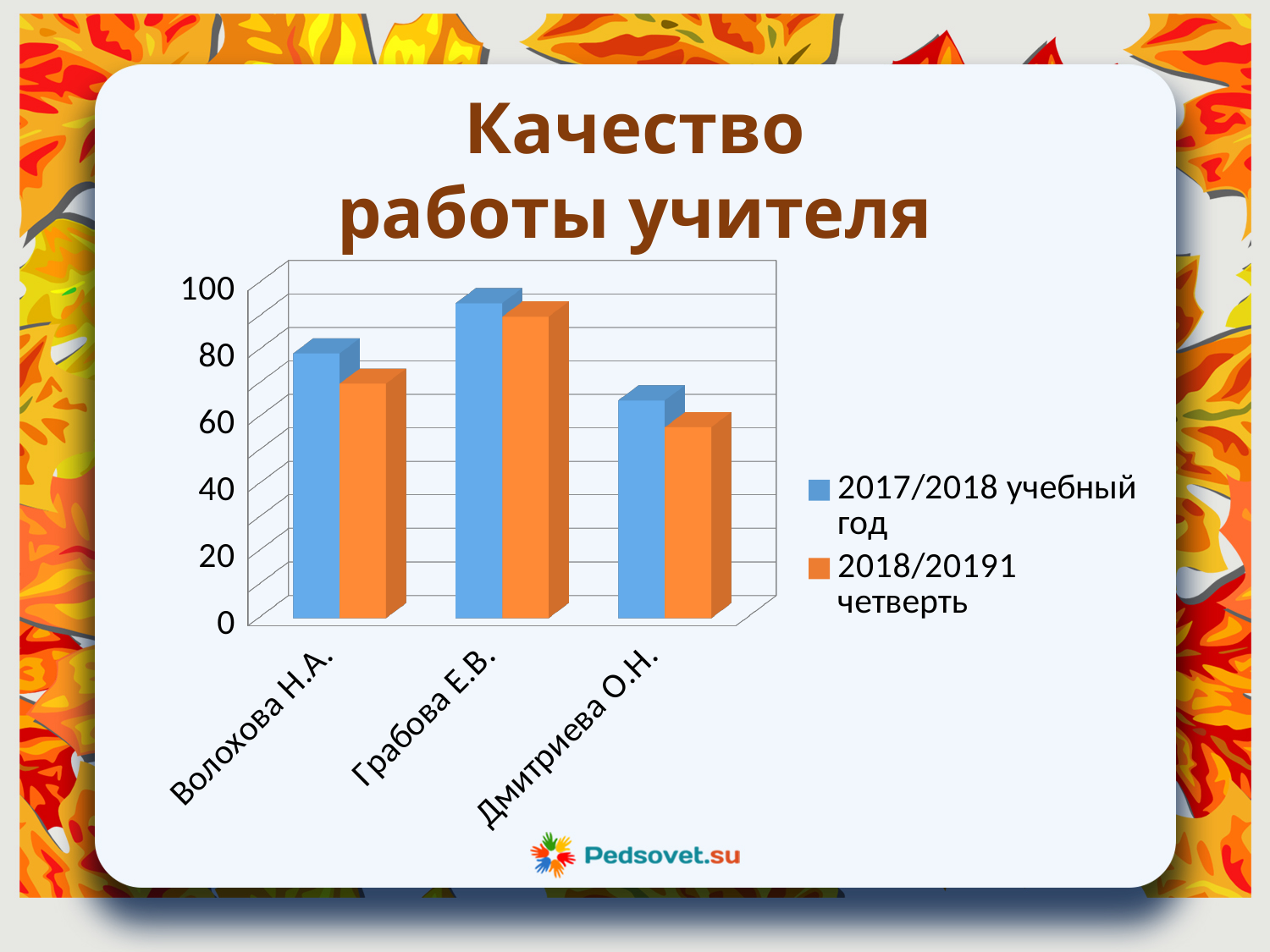
Which teacher has the highest value for the 2017/2018 учебный год series? Грабова Е.В. Is the value for Дмитриева О.Н. in the 2018/2019 1 четверть series greater or less than 80? less Which teacher has the lowest value for the 2017/2018 учебный год series? Дмитриева О.Н. How many series does the chart's legend list? 2 Which teacher has the lowest value for the 2018/2019 1 четверть series? Дмитриева О.Н. For Волохова Н.А., which series has the larger value: 2017/2018 учебный год or 2018/2019 1 четверть? 2017/2018 учебный год Is the value for Грабова Е.В. in the 2017/2018 учебный год series greater or less than 80? greater Is the value for Волохова Н.А. in the 2017/2018 учебный год series greater or less than 60? greater How many teachers (categories) are shown on the x axis of the chart? 3 Which colour represents the 2018/2019 1 четверть series in the chart? orange What is the title of the slide containing the chart? Качество работы учителя What kind of chart is shown on the slide? bar chart